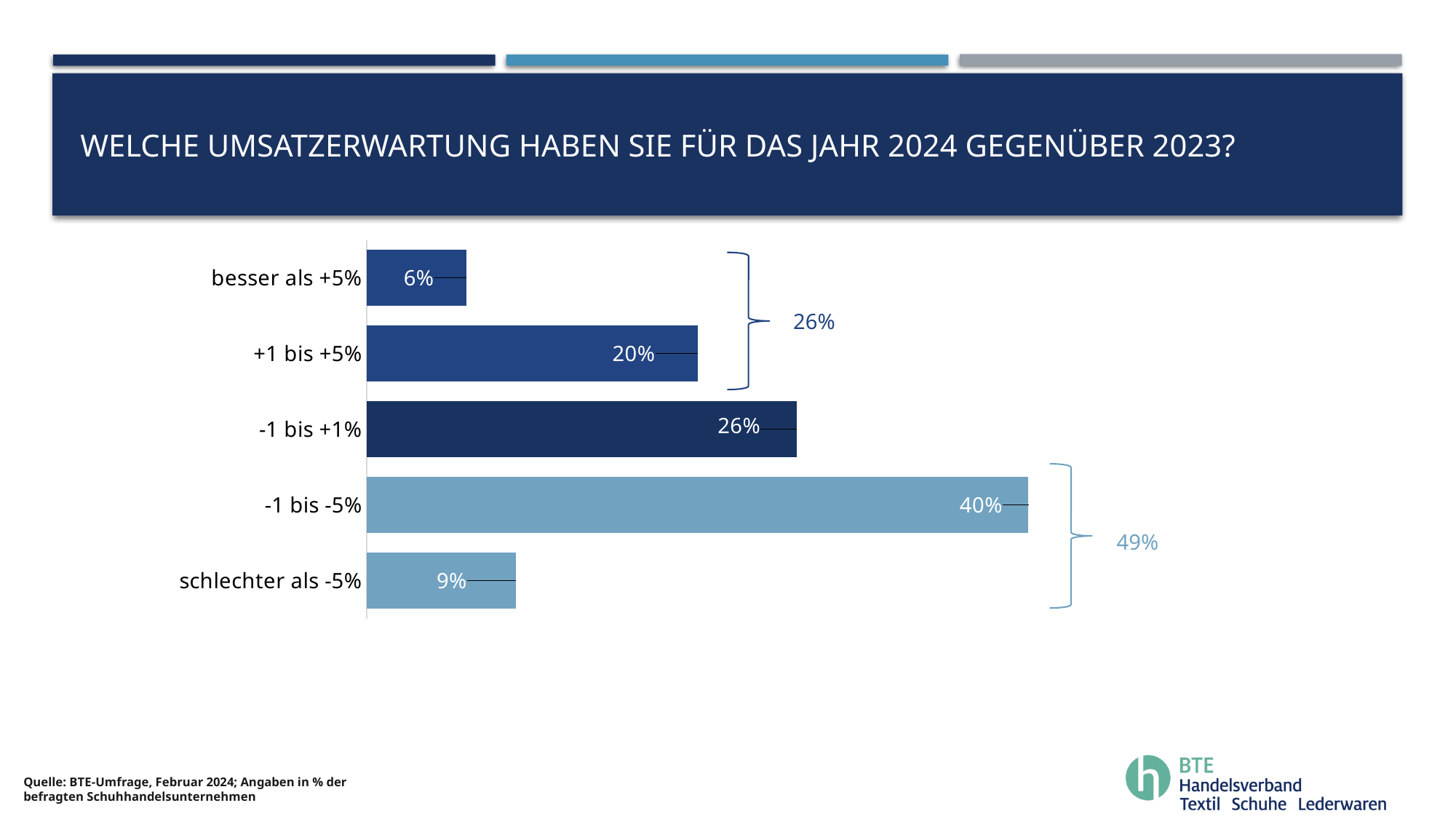
What combined percentage is shown by the bracket grouping "besser als +5%" and "+1 bis +5%"? 26% What is the value for the category "besser als +5%"? 6% What is the value for the category "+1 bis +5%"? 20% Which is larger, the value for "+1 bis +5%" or the value for "schlechter als -5%"? +1 bis +5% What is the difference between the values for "-1 bis -5%" and "-1 bis +1%"? 14% Which category has the lowest value? besser als +5% What is the value for the category "schlechter als -5%"? 9% What is the value for the category "-1 bis -5%"? 40% What kind of chart is shown on the slide? Bar chart Which category has the highest value? -1 bis -5% How many categories are shown in the chart? 5 What combined percentage is shown by the bracket grouping "-1 bis -5%" and "schlechter als -5%"? 49%